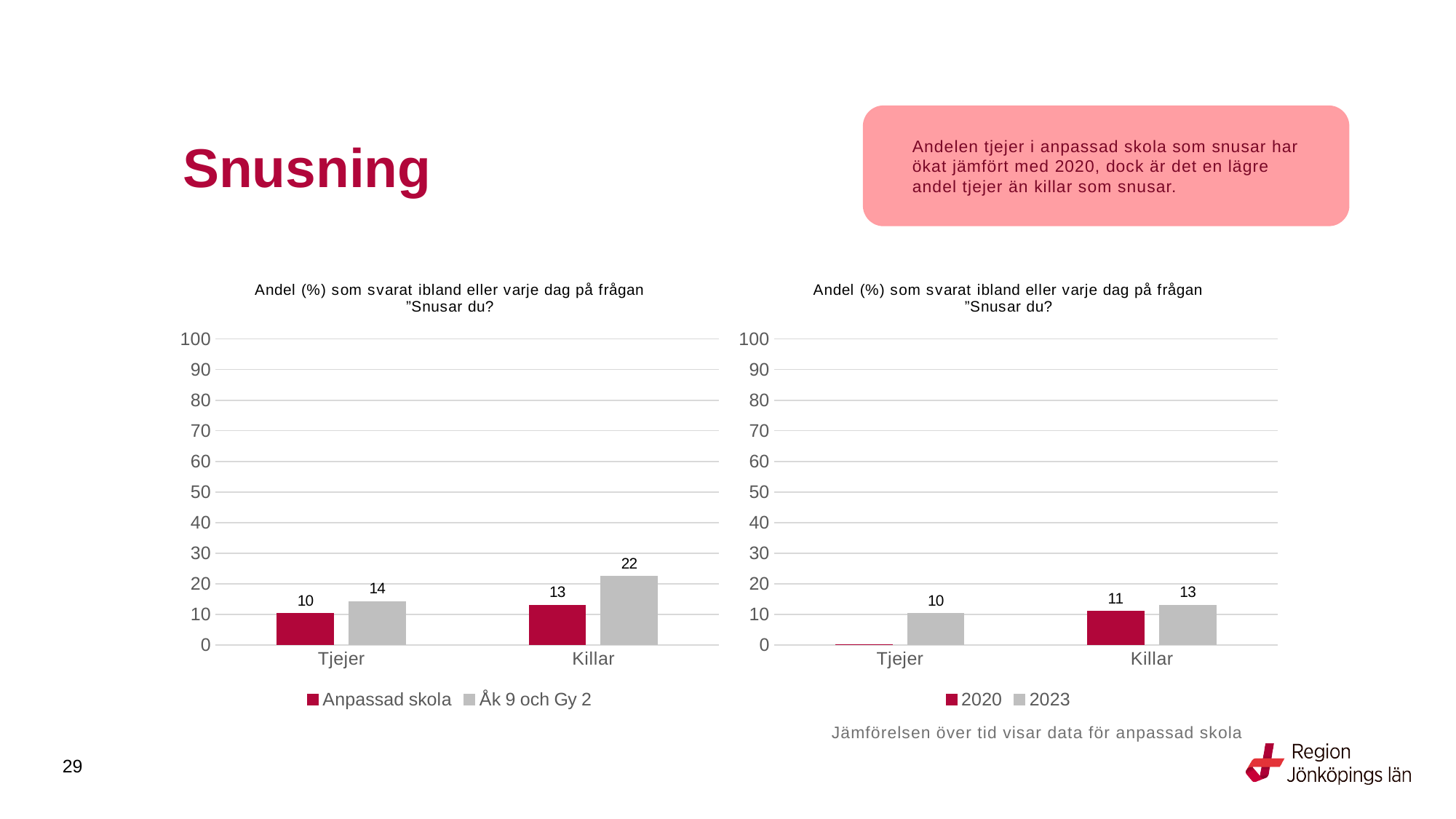
What are the two series listed in the legend of the left chart? Anpassad skola and Åk 9 och Gy 2 What kind of chart is the left chart? Bar chart In the right chart, what is the value for Killar in 2023? 13 In the right chart, is the 2023 value for Killar greater or less than 20? less In the left chart, what is the value for Killar in the Åk 9 och Gy 2 series? 22 In the right chart, what is the difference between the 2023 and 2020 values for Killar? 2 In the right chart, what is the value for Tjejer in 2023? 10 In the left chart, which category has the highest value in the Åk 9 och Gy 2 series? Killar How many series does the legend of the right chart list? 2 In the left chart, which is larger for Tjejer: Anpassad skola or Åk 9 och Gy 2? Åk 9 och Gy 2 In the left chart, what is the difference between the Åk 9 och Gy 2 and Anpassad skola values for Killar? 9 In the left chart, what is the value for Tjejer in the Anpassad skola series? 10